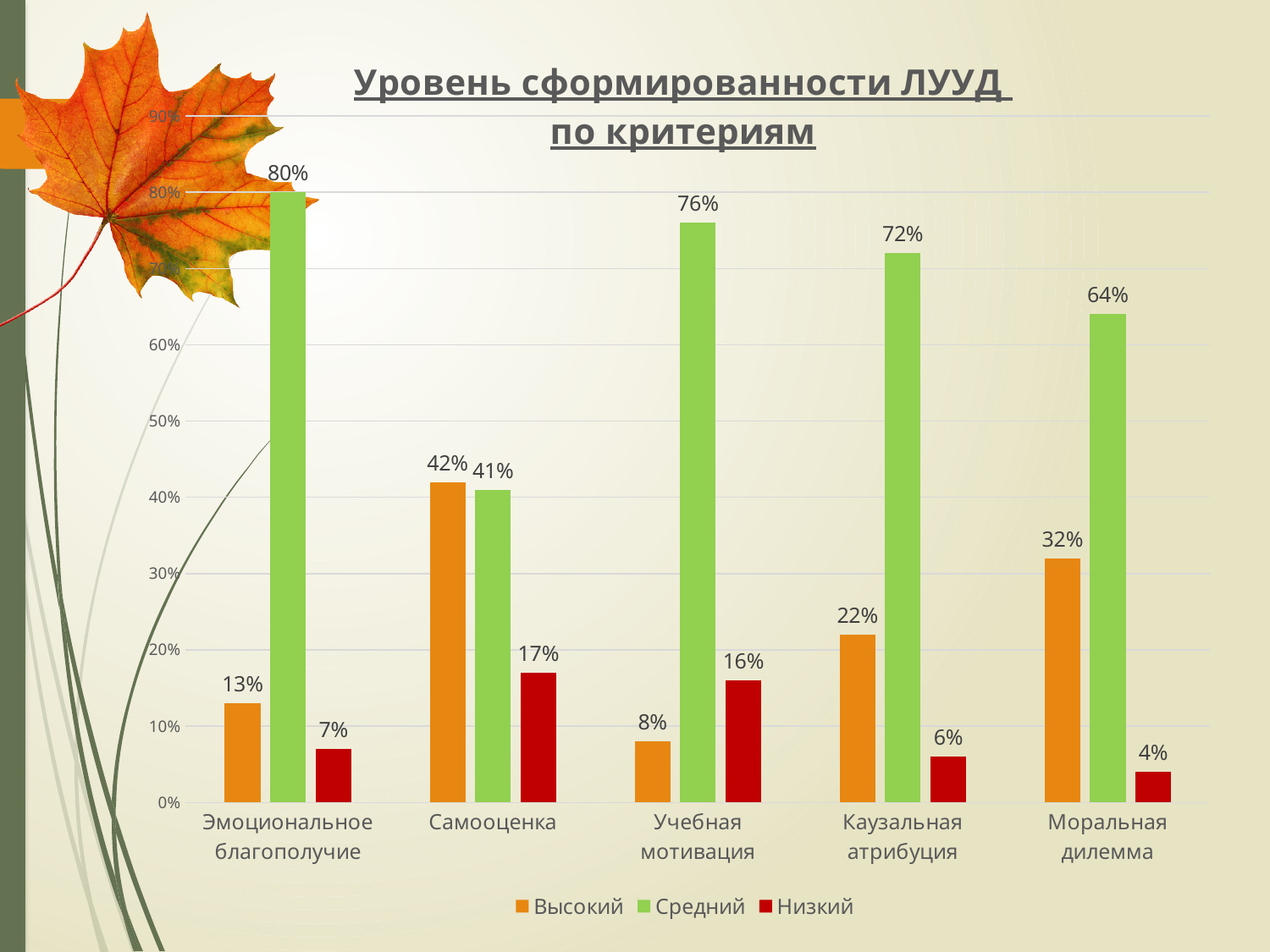
What is the value of the Средний series for Эмоциональное благополучие? 80% What is the value of the Высокий series for Самооценка? 42% What kind of chart is shown on the slide? Bar chart What colour represents the Низкий series in the legend? Red Which is larger for Каузальная атрибуция: the Высокий value or the Низкий value? Высокий Which category has the lowest value for the Низкий series? Моральная дилемма How many categories are shown on the x axis? 5 What is the value of the Низкий series for Учебная мотивация? 16% How many series does the legend list? 3 Which category has the highest value for the Высокий series? Самооценка What is the difference between the Средний and Высокий values for Моральная дилемма? 32% Which category has the lowest value for the Средний series? Самооценка